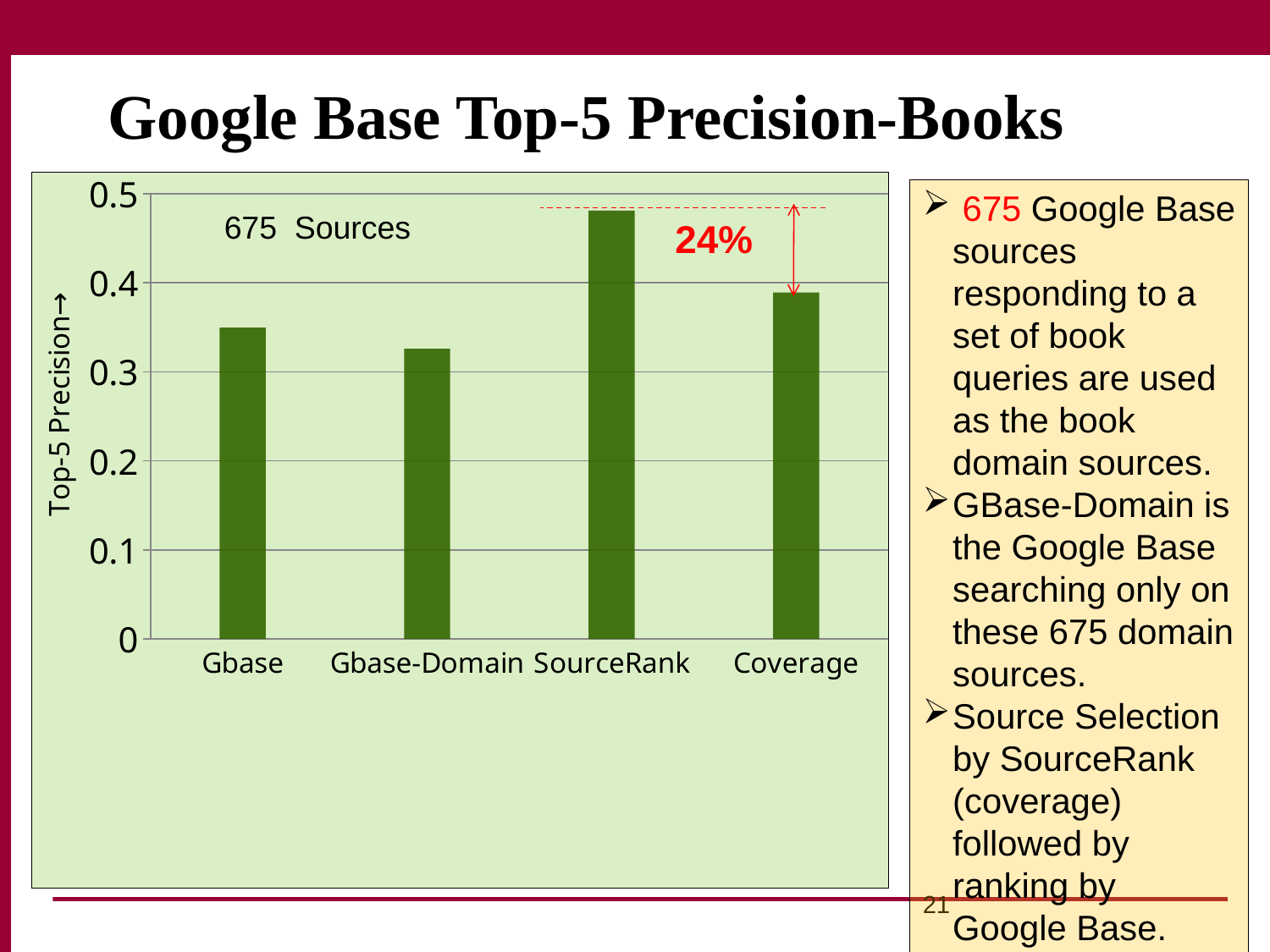
What is the label of the y axis of the chart? Top-5 Precision What kind of chart is shown on the slide? bar chart Is the value for Coverage greater or less than 0.3? greater How many categories are plotted on the x axis of the chart? 4 Which category has the lowest Top-5 Precision? Gbase-Domain Which has a higher Top-5 Precision, SourceRank or Coverage? SourceRank Is the value for SourceRank greater or less than 0.4? greater Which category has the highest Top-5 Precision? SourceRank Is the value for Gbase-Domain greater or less than 0.4? less Which has a higher Top-5 Precision, Gbase or Coverage? Coverage What percentage is annotated in red between the SourceRank and Coverage bars? 24%